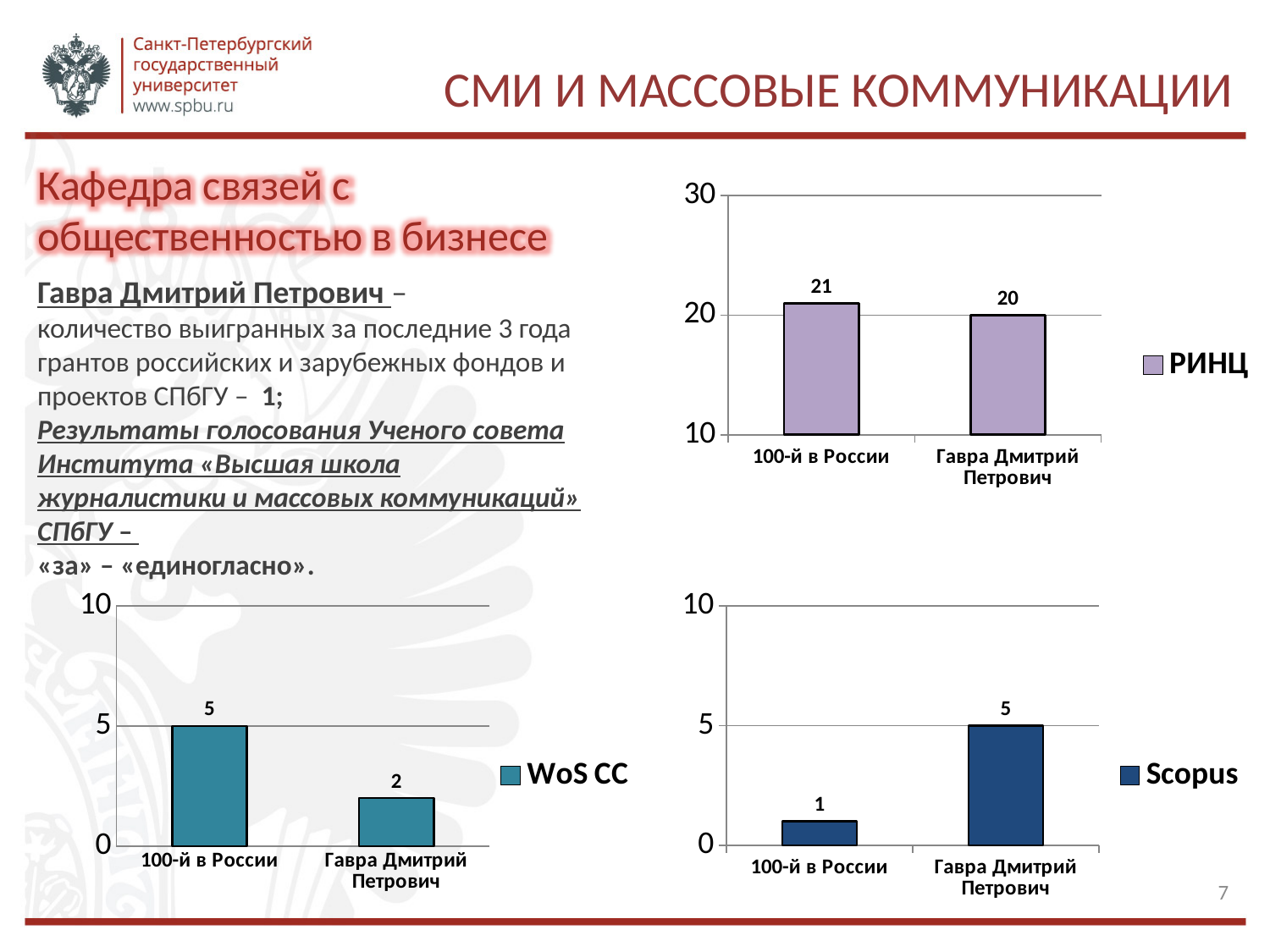
How many categories are shown in the Scopus chart (bottom right)? 2 In the РИНЦ chart (top right), what is the value for Гавра Дмитрий Петрович? 20 In the РИНЦ chart (top right), what is the difference between the values for 100-й в России and Гавра Дмитрий Петрович? 1 What kind of chart is the WoS CC chart (bottom left)? bar chart How many series does the legend of the РИНЦ chart (top right) list? 1 In the WoS CC chart (bottom left), which category has the highest value? 100-й в России In the WoS CC chart (bottom left), what is the difference between the values for 100-й в России and Гавра Дмитрий Петрович? 3 In the Scopus chart (bottom right), what is the value for 100-й в России? 1 In the Scopus chart (bottom right), which is larger: the value for Гавра Дмитрий Петрович or the value for 100-й в России? Гавра Дмитрий Петрович In the РИНЦ chart (top right), what is the value for 100-й в России? 21 In the Scopus chart (bottom right), which category has the lowest value? 100-й в России In the WoS CC chart (bottom left), what is the value for Гавра Дмитрий Петрович? 2